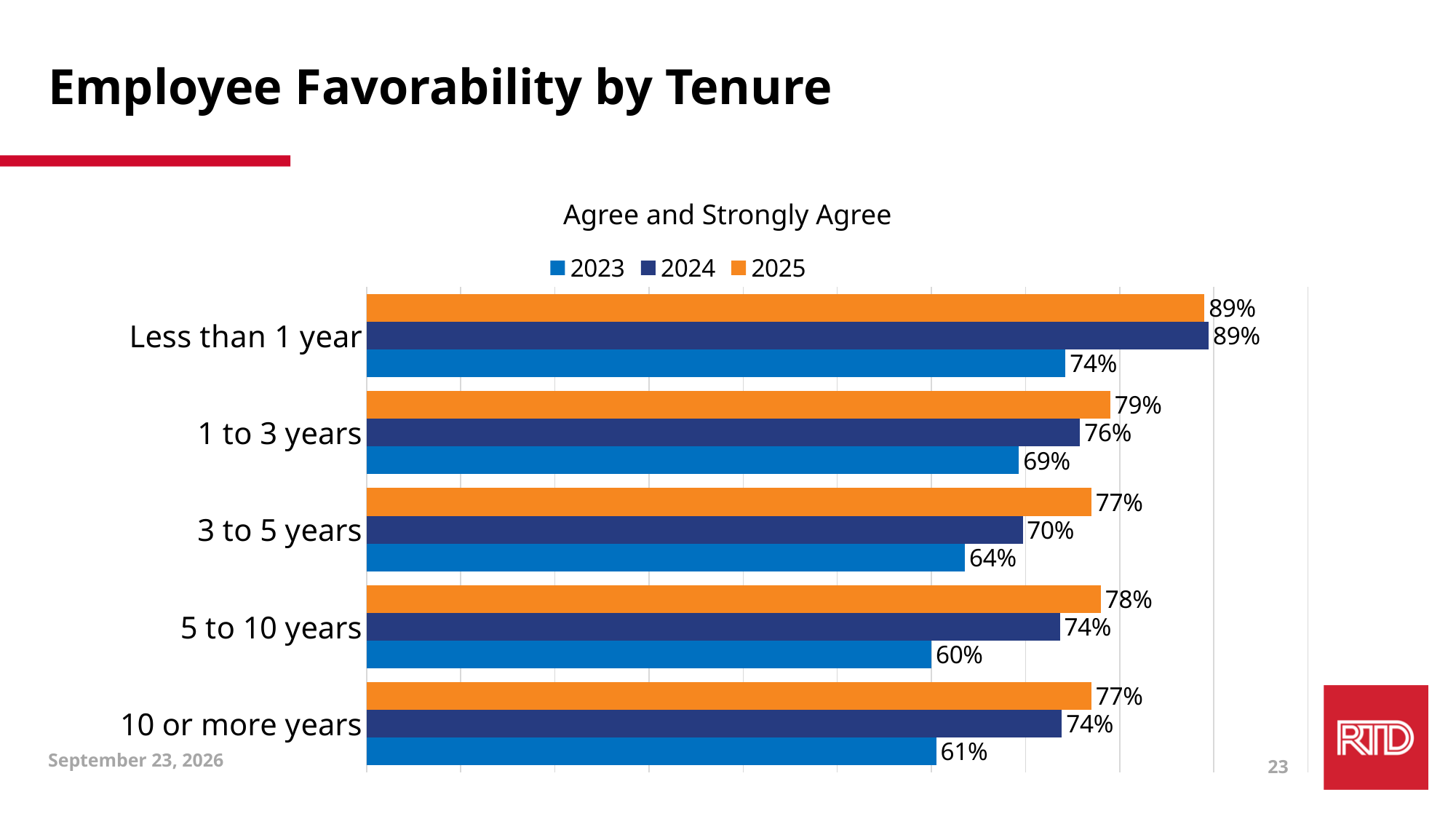
Which is larger for '1 to 3 years': the 2024 value or the 2025 value? 2025 Which tenure category has the highest 2023 value? Less than 1 year How many series does the legend list? 3 What kind of chart is shown on the slide? Bar chart What is the 2024 value for '3 to 5 years'? 70% What is the title of the chart? Agree and Strongly Agree What is the 2025 value for 'Less than 1 year'? 89% How many tenure categories are shown on the chart? 5 What is the difference between the 2025 and 2023 values for '5 to 10 years'? 18% What is the 2023 value for '5 to 10 years'? 60% Which colour represents the 2025 series in the legend? Orange Which tenure category has the lowest 2023 value? 5 to 10 years